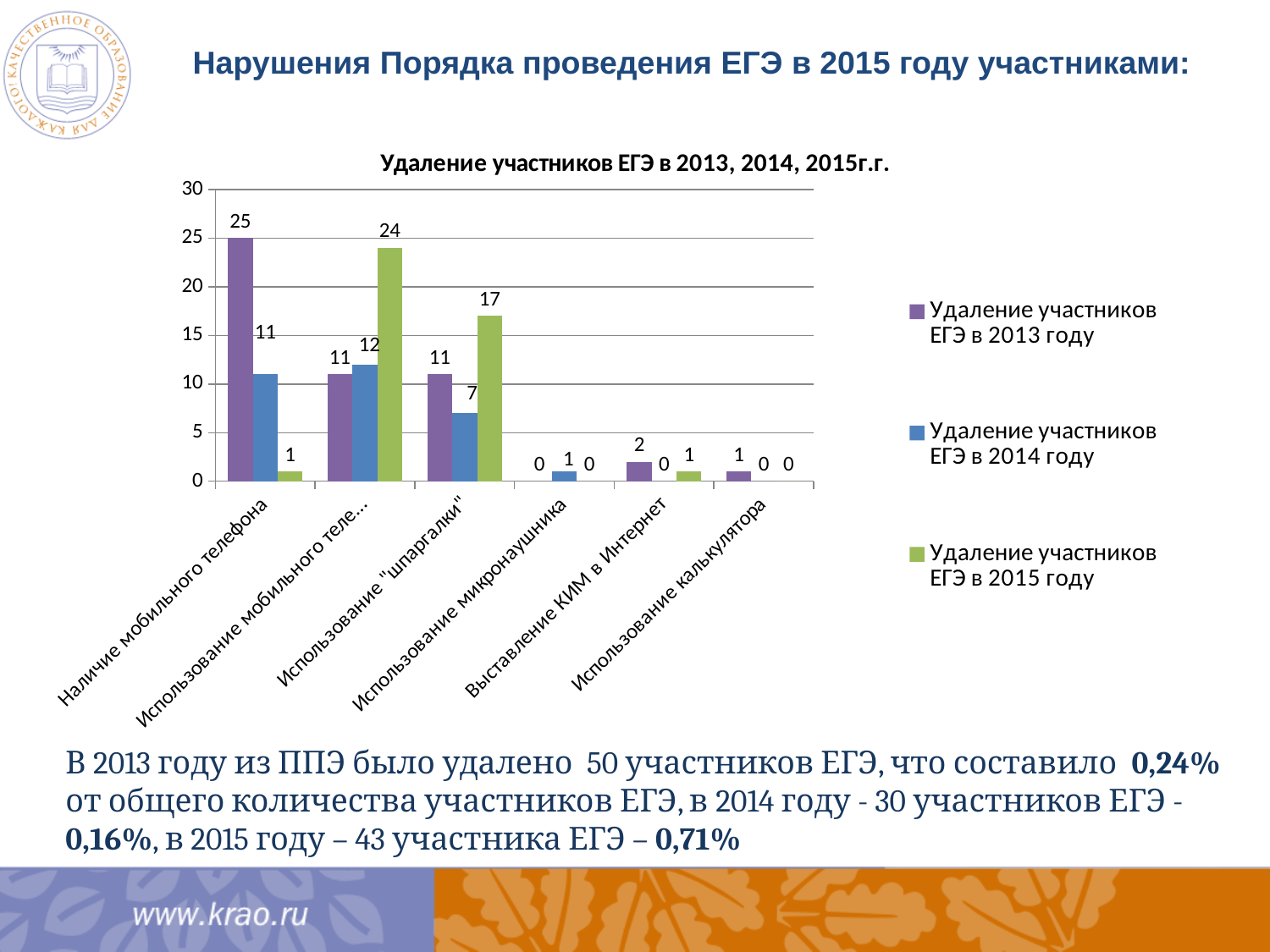
What is the value for "Использование "шпаргалки"" in the series "Удаление участников ЕГЭ в 2015 году"? 17 How many categories are shown on the x axis? 6 Is the value for "Наличие мобильного телефона" in 2013 greater or less than 20? greater What type of chart is shown on the slide? bar chart What is the title of the chart? Удаление участников ЕГЭ в 2013, 2014, 2015г.г. How many series does the legend list? 3 Which category has the highest value in the series "Удаление участников ЕГЭ в 2013 году"? Наличие мобильного телефона What is the difference between the 2013 and 2015 values for "Наличие мобильного телефона"? 24 For "Использование "шпаргалки"", which is larger: the 2014 value or the 2015 value? 2015 value Which category has the highest value in the series "Удаление участников ЕГЭ в 2015 году"? Использование мобильного теле... What is the value for "Наличие мобильного телефона" in the series "Удаление участников ЕГЭ в 2013 году"? 25 What is the value for "Выставление КИМ в Интернет" in the series "Удаление участников ЕГЭ в 2013 году"? 2